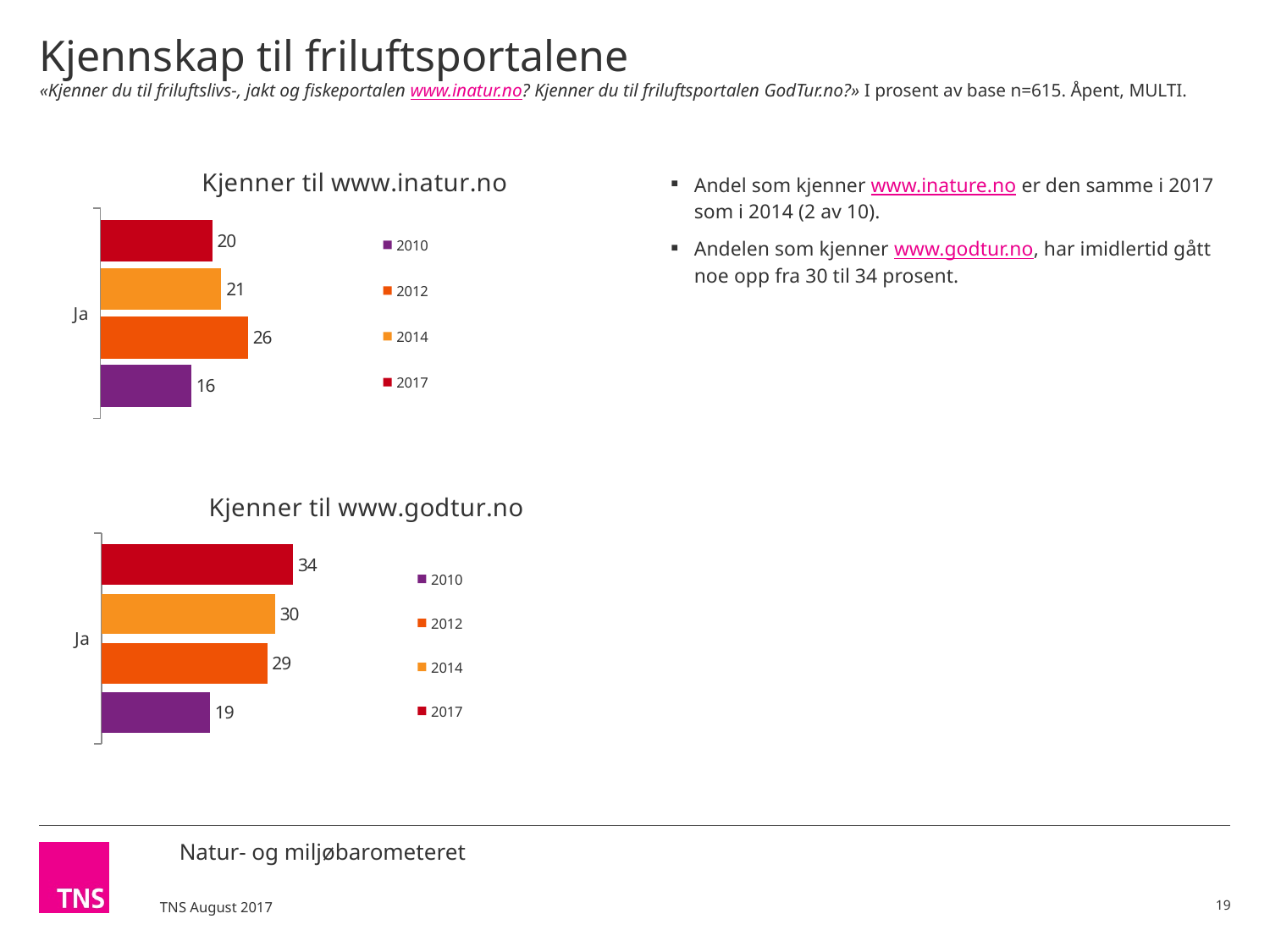
In the chart 'Kjenner til www.godtur.no', which is larger, the value for 2017 or the value for 2012? 2017 How many series does the legend of the chart 'Kjenner til www.godtur.no' list? 4 In the chart 'Kjenner til www.godtur.no', what is the value for 2014? 30 In the chart 'Kjenner til www.inatur.no', what is the value for 2010? 16 In the chart 'Kjenner til www.godtur.no', what is the value for 2017? 34 What type of chart is 'Kjenner til www.inatur.no'? Bar chart In the chart 'Kjenner til www.godtur.no', what is the difference between the 2017 value and the 2010 value? 15 In the chart 'Kjenner til www.inatur.no', what is the value for 2017? 20 In the chart 'Kjenner til www.inatur.no', which year has the lowest value? 2010 In the chart 'Kjenner til www.inatur.no', which year has the highest value? 2012 In the chart 'Kjenner til www.godtur.no', which year has the lowest value? 2010 In the chart 'Kjenner til www.inatur.no', what is the difference between the 2012 value and the 2010 value? 10